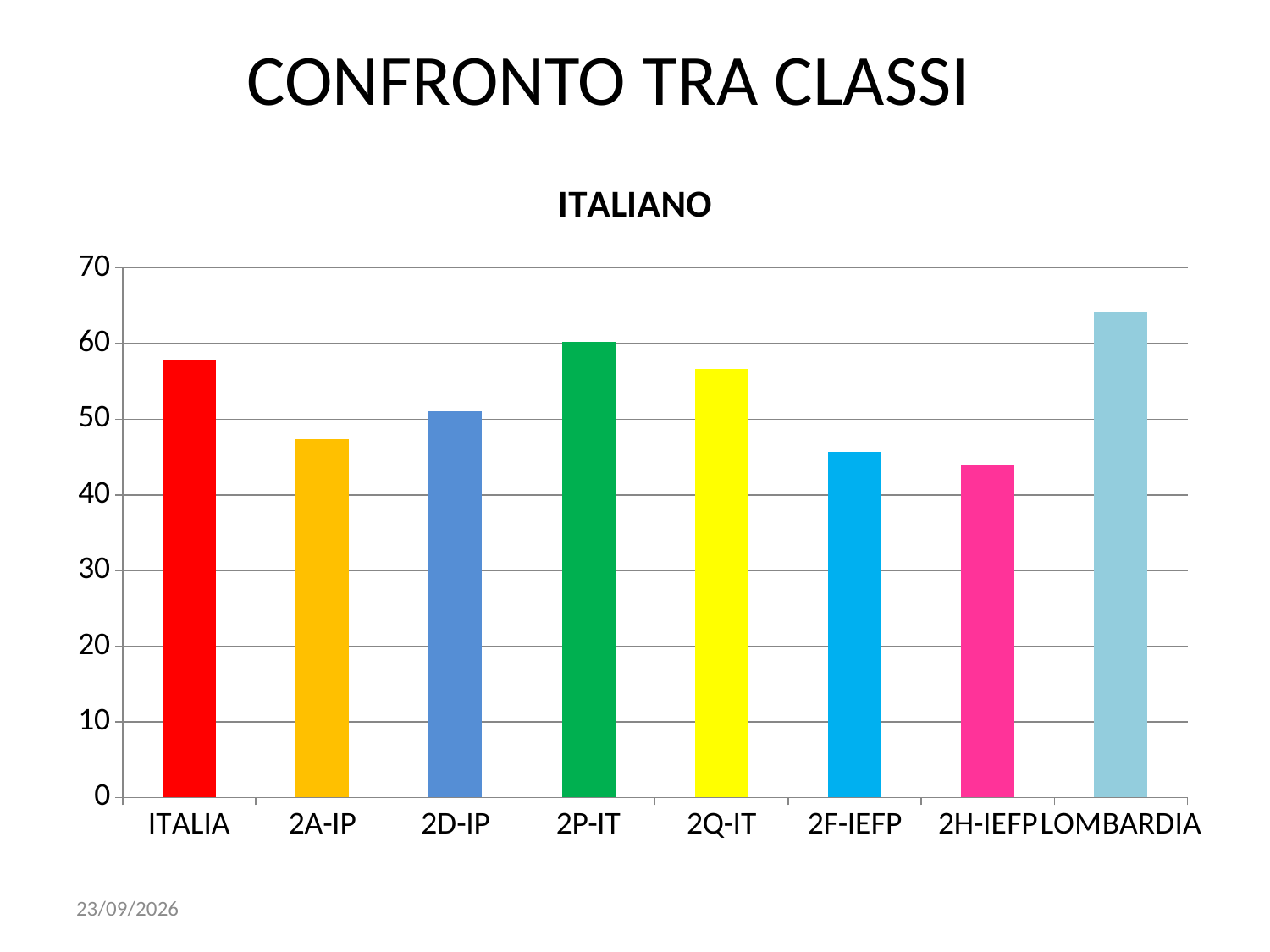
Is the value for ITALIA greater or less than 50? greater Which category has the lowest bar in the chart? 2H-IEFP How many categories are shown on the x axis of the chart? 8 What colour is the bar for ITALIA? red Which is larger, the value for ITALIA or the value for LOMBARDIA? LOMBARDIA Is the value for 2A-IP greater or less than 50? less What kind of chart is shown on the slide? bar chart What is the title of the chart? ITALIANO Which is larger, the value for 2P-IT or the value for 2Q-IT? 2P-IT Is the value for 2H-IEFP greater or less than 50? less Which category has the highest bar in the chart? LOMBARDIA